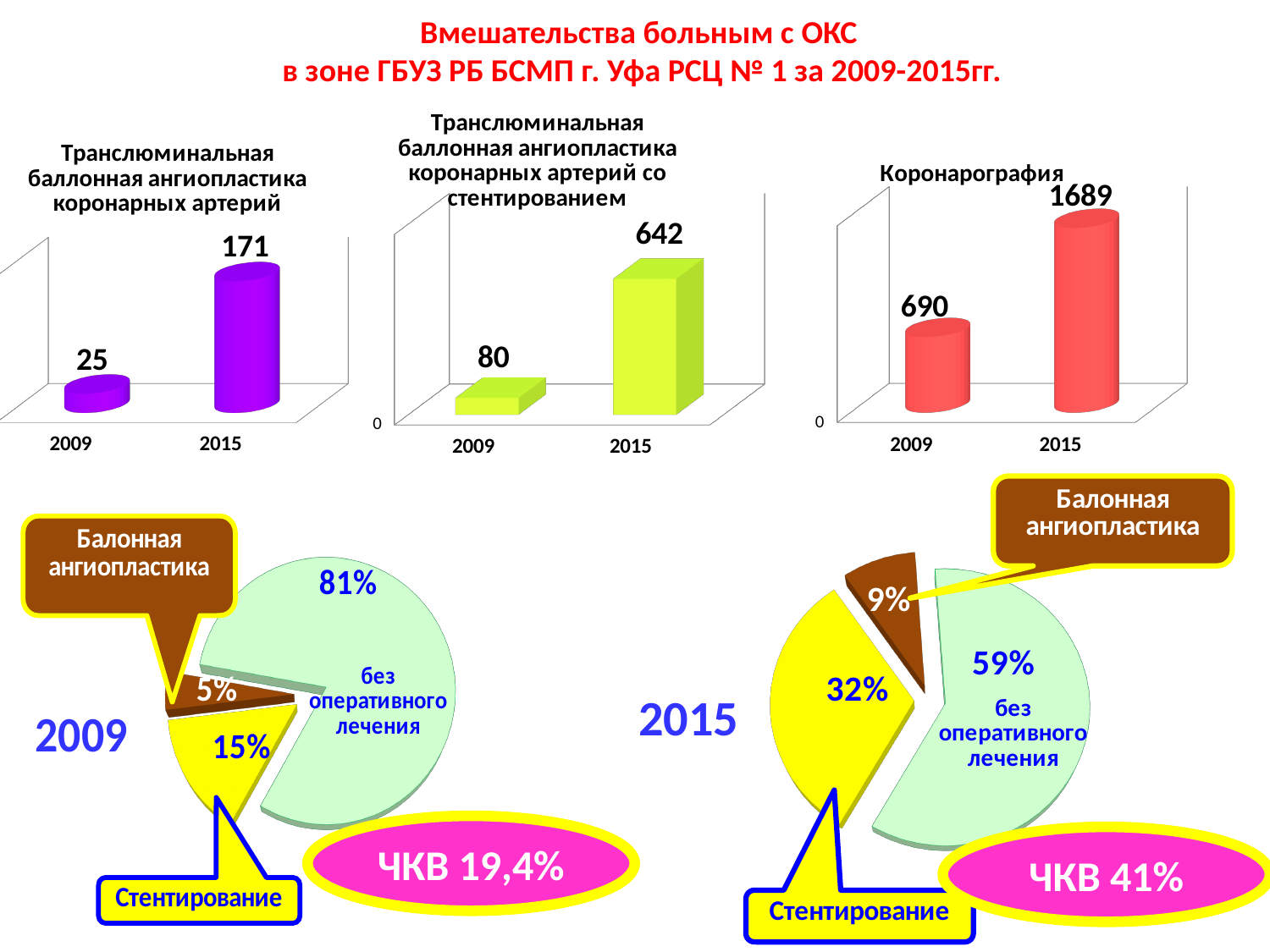
In the 'Транслюминальная баллонная ангиопластика коронарных артерий со стентированием' bar chart, what is the difference between the 2015 and 2009 values? 562 In the 'Коронарография' bar chart, which year has the higher value? 2015 In the 2015 pie chart, what share corresponds to 'Стентирование'? 32% In the 2009 pie chart, what share is labelled 'без оперативного лечения'? 81% In the 'Транслюминальная баллонная ангиопластика коронарных артерий со стентированием' bar chart, what is the value for 2015? 642 In the 2015 pie chart, what share corresponds to 'Балонная ангиопластика'? 9% How many categories are shown on the x axis of the 'Транслюминальная баллонная ангиопластика коронарных артерий' bar chart? 2 What kind of chart is the 'Коронарография' chart? Bar chart In the 'Транслюминальная баллонная ангиопластика коронарных артерий' bar chart, what is the value for 2015? 171 In the 'Коронарография' bar chart, what is the difference between the 2015 and 2009 values? 999 In the 'Транслюминальная баллонная ангиопластика коронарных артерий' bar chart, what is the value for 2009? 25 In the 'Коронарография' bar chart, what is the value for 2009? 690